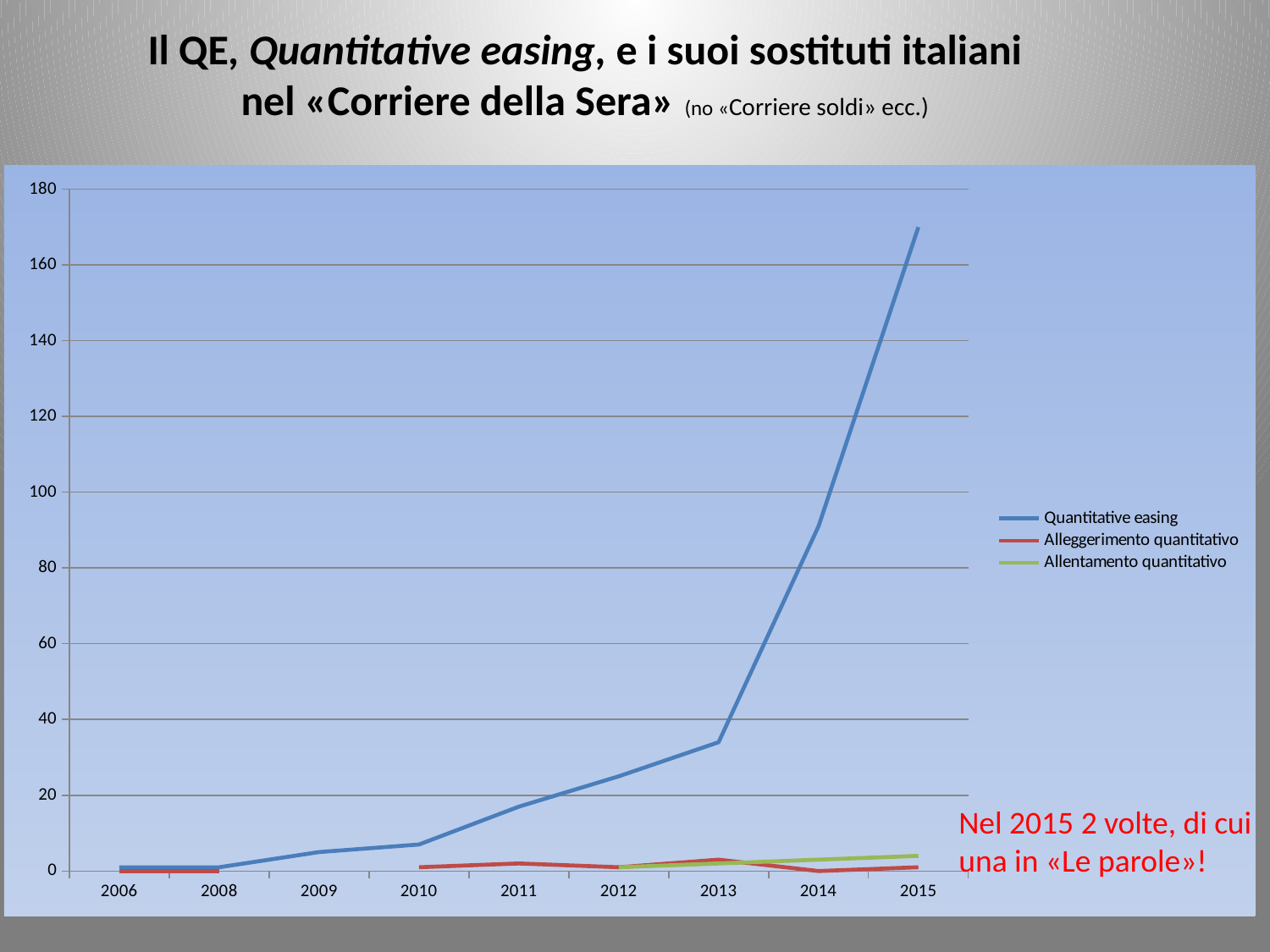
How many years are shown on the x axis? 9 What kind of chart is shown on the slide? line chart Is the value for Quantitative easing in 2014 greater or less than 100? less In which year does the Quantitative easing series reach its highest value? 2015 What colour is the Quantitative easing line in the legend? blue How many series does the legend list? 3 Does the Quantitative easing series rise or fall from 2006 to 2015? rises Which year has the higher value for Quantitative easing, 2013 or 2014? 2014 Is the value for Quantitative easing in 2015 greater or less than 160? greater Is the value for Quantitative easing in 2013 greater or less than 40? less In 2015, which series is higher, Allentamento quantitativo or Alleggerimento quantitativo? Allentamento quantitativo